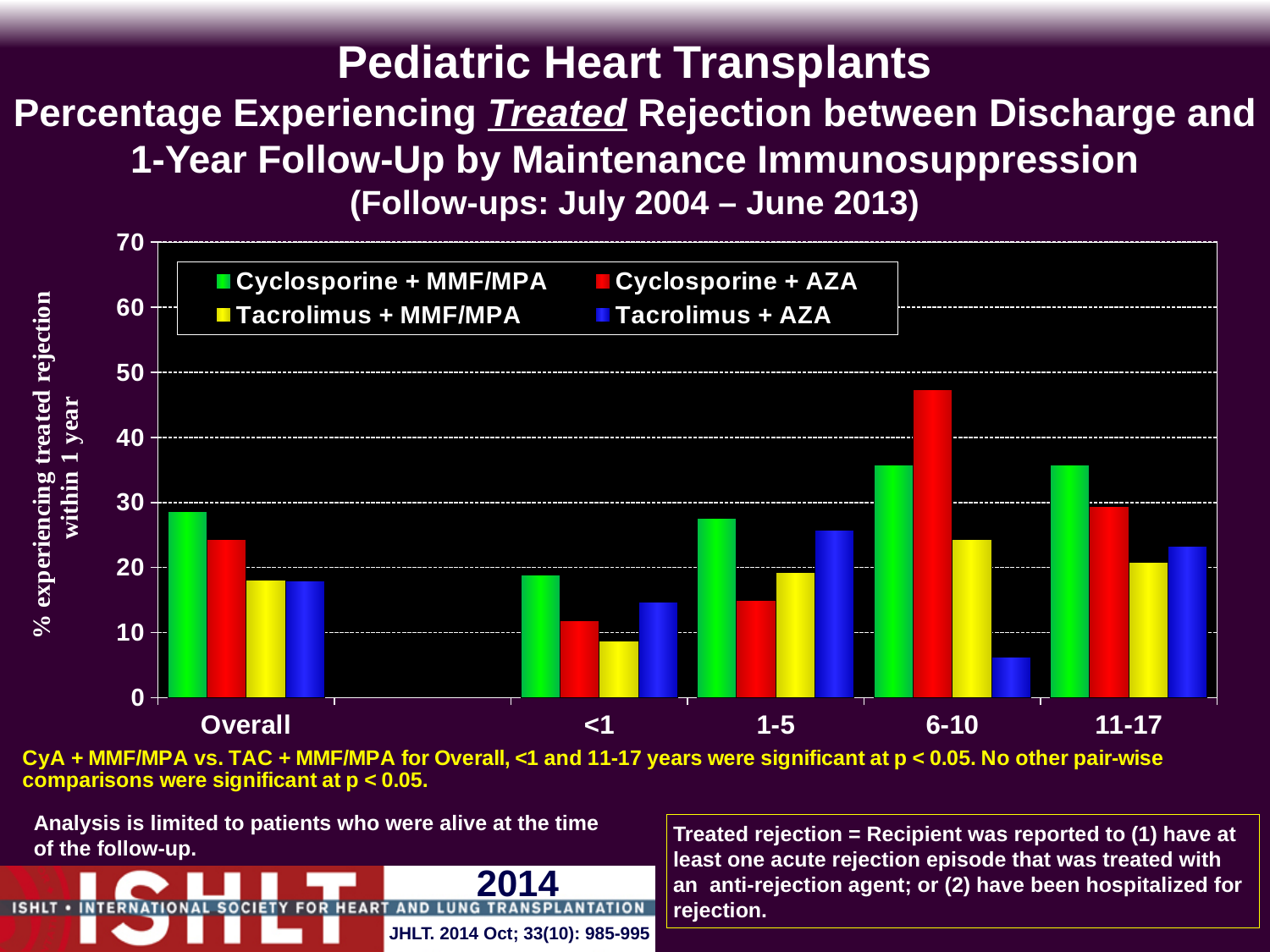
In the Overall group, which is larger: Cyclosporine + MMF/MPA or Cyclosporine + AZA? Cyclosporine + MMF/MPA In the 1-5 group, which is larger: Tacrolimus + AZA or Cyclosporine + AZA? Tacrolimus + AZA Is the value for Cyclosporine + MMF/MPA in the <1 group greater or less than 10? greater Which age group has the highest value for Cyclosporine + AZA? 6-10 Is the value for Tacrolimus + AZA in the 6-10 group greater or less than 10? less Which age group has the lowest value for Tacrolimus + MMF/MPA? <1 How many series does the legend list? 4 What is the label of the y axis? % experiencing treated rejection within 1 year Which age group has the lowest value for Tacrolimus + AZA? 6-10 Is the value for Cyclosporine + AZA in the 6-10 group greater or less than 40? greater What kind of chart is shown on the slide? bar chart How many categories are shown along the x axis? 5